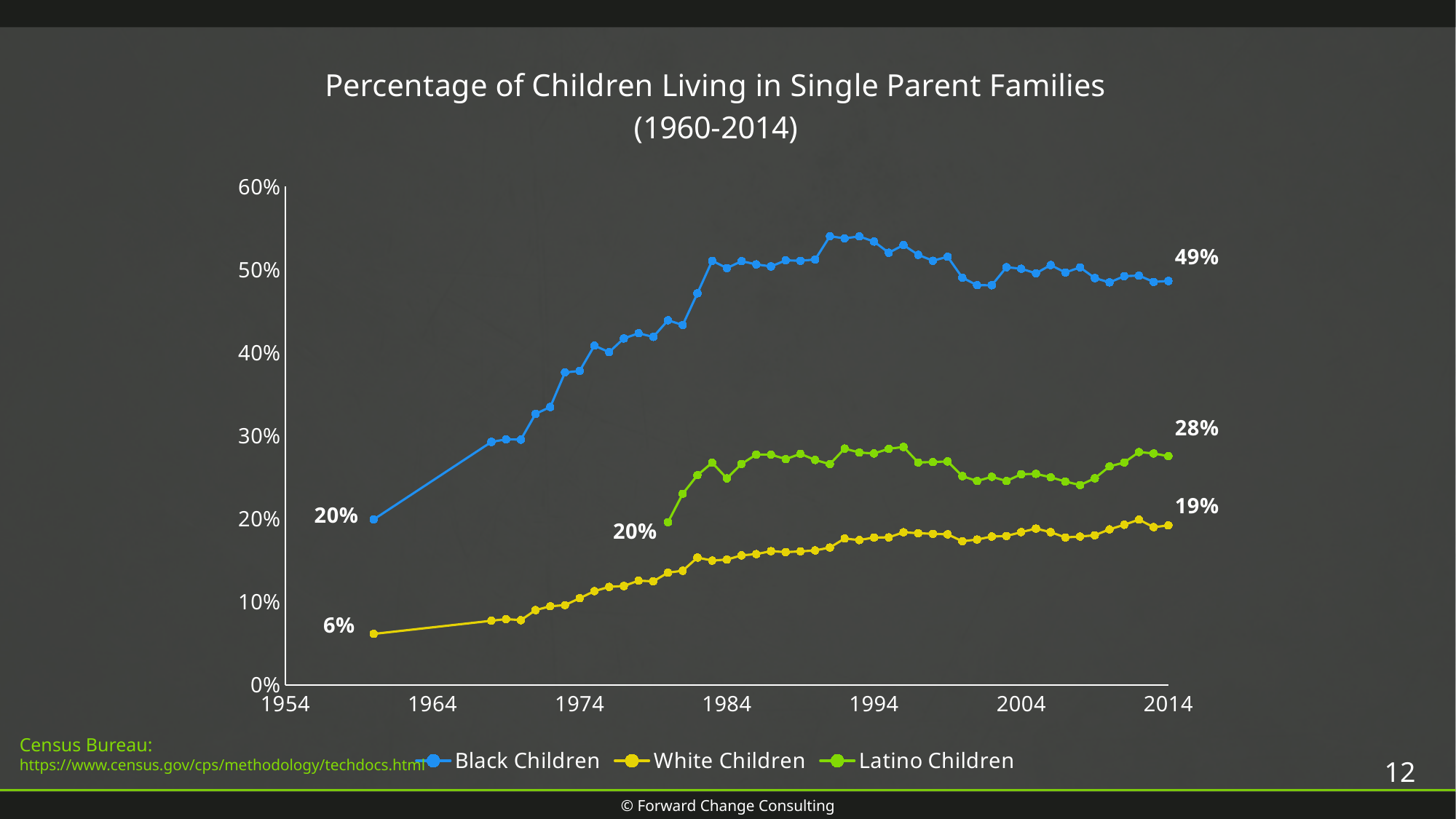
Which series has the lowest value in 2014? White Children Which series has the highest value in 2014? Black Children What is the difference between the Latino Children and White Children values in 2014? 9% Is the value for Black Children in 1994 greater or less than 50%? greater What is the value for White Children at the start of the series in 1960? 6% What type of chart is shown on the slide? line chart Does the White Children series generally rise or fall from 1960 to 2014? rise What is the value for Latino Children in 2014? 28% What is the value for Black Children in 2014? 49% What is the difference between the Black Children value in 2014 and the Black Children value in 1960? 29% What is the value for White Children in 2014? 19% How many series does the legend list? 3